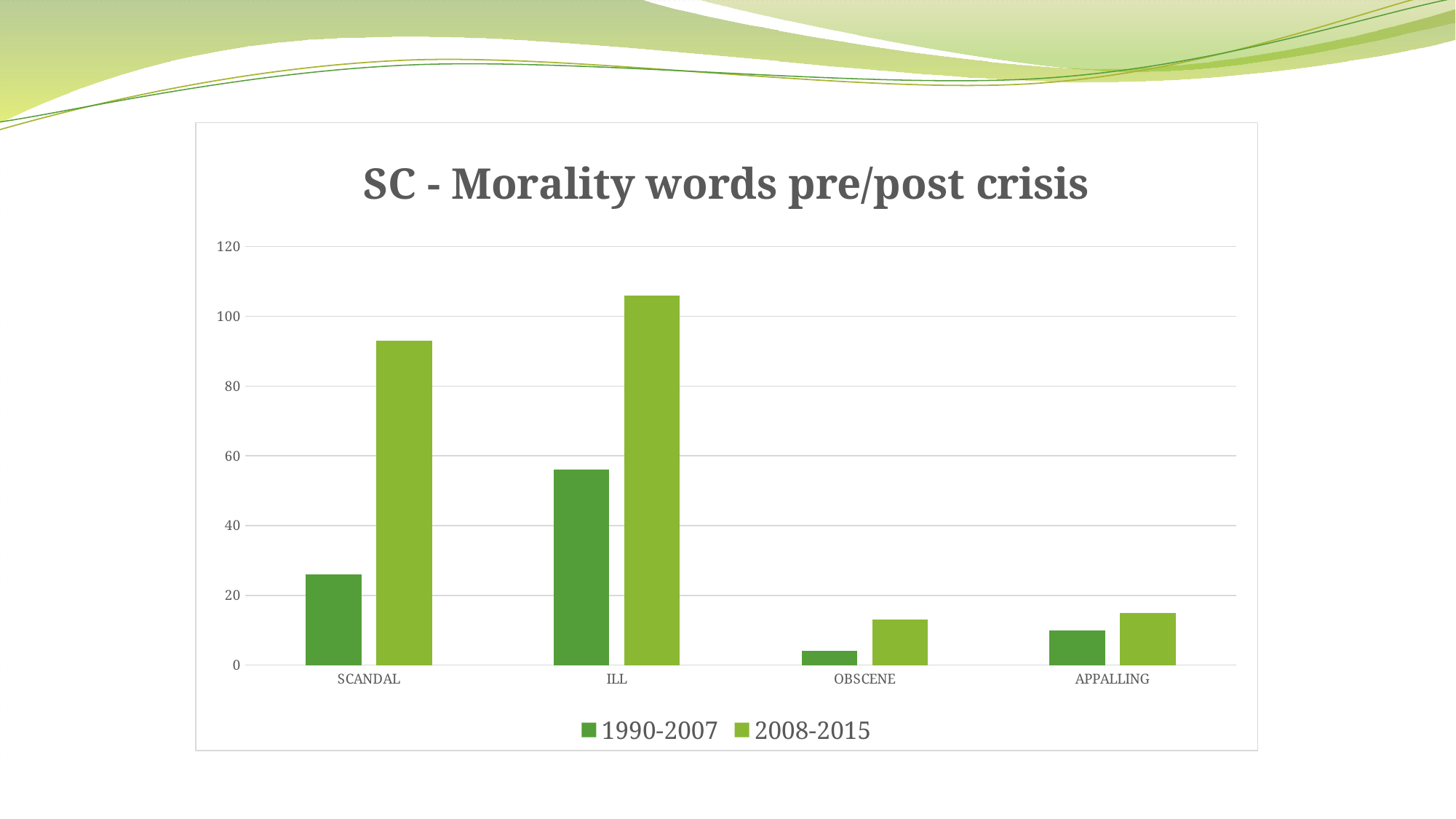
Is the 1990-2007 value for SCANDAL greater or less than 20? greater Is the 2008-2015 value for SCANDAL greater or less than 80? greater Which series is shown in the darker green colour in the legend? 1990-2007 What type of chart is shown on the slide? bar chart Is the 2008-2015 value for ILL greater or less than 100? greater What is the title of the chart? SC - Morality words pre/post crisis Which category has the lowest value for the 1990-2007 series? OBSCENE Which is larger for the 1990-2007 series: SCANDAL or ILL? ILL How many word categories are shown on the x axis? 4 How many series does the legend list? 2 Which category has the highest value for the 2008-2015 series? ILL